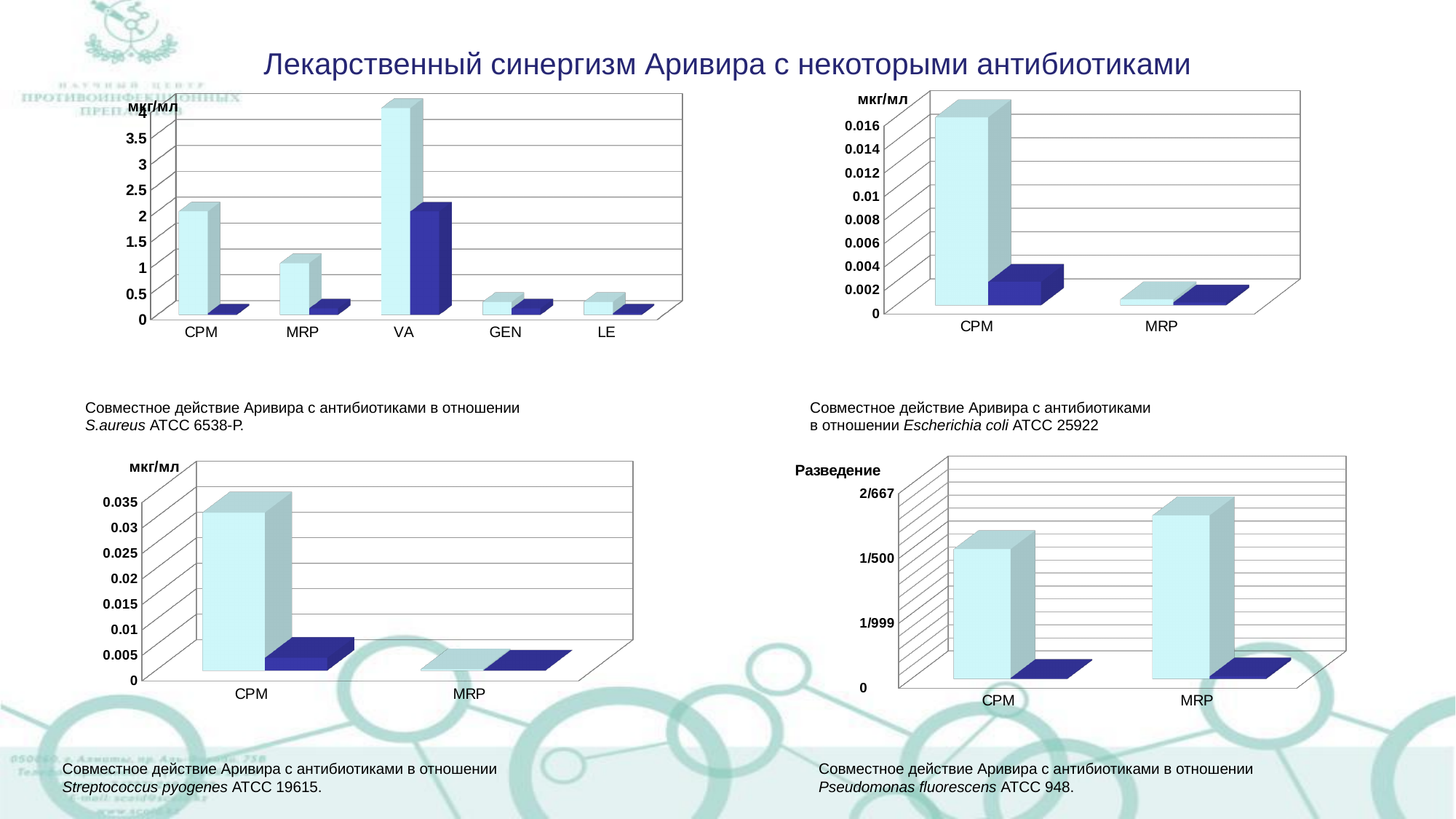
In the top-left chart (S.aureus ATCC 6538-P), which light-blue bar is taller, CPM or MRP? CPM In the bottom-right chart (Pseudomonas fluorescens ATCC 948), which light-blue bar is taller, CPM or MRP? MRP In the top-left chart (S.aureus ATCC 6538-P), is the light-blue bar for CPM greater or less than 1.5 мкг/мл? greater In the top-left chart (S.aureus ATCC 6538-P), is the light-blue bar for VA greater or less than 3 мкг/мл? greater How many categories are shown on the x axis of the top-right chart (Escherichia coli ATCC 25922)? 2 In the top-right chart (Escherichia coli ATCC 25922), is the light-blue bar for CPM greater or less than 0.01 мкг/мл? greater How many antibiotic categories are shown on the x axis of the top-left chart (S.aureus ATCC 6538-P)? 5 What kind of chart is the top-left chart (S.aureus ATCC 6538-P)? bar chart In the top-left chart (S.aureus ATCC 6538-P), which antibiotic has the tallest light-blue bar? VA In the top-right chart (Escherichia coli ATCC 25922), which category has the tallest light-blue bar? CPM